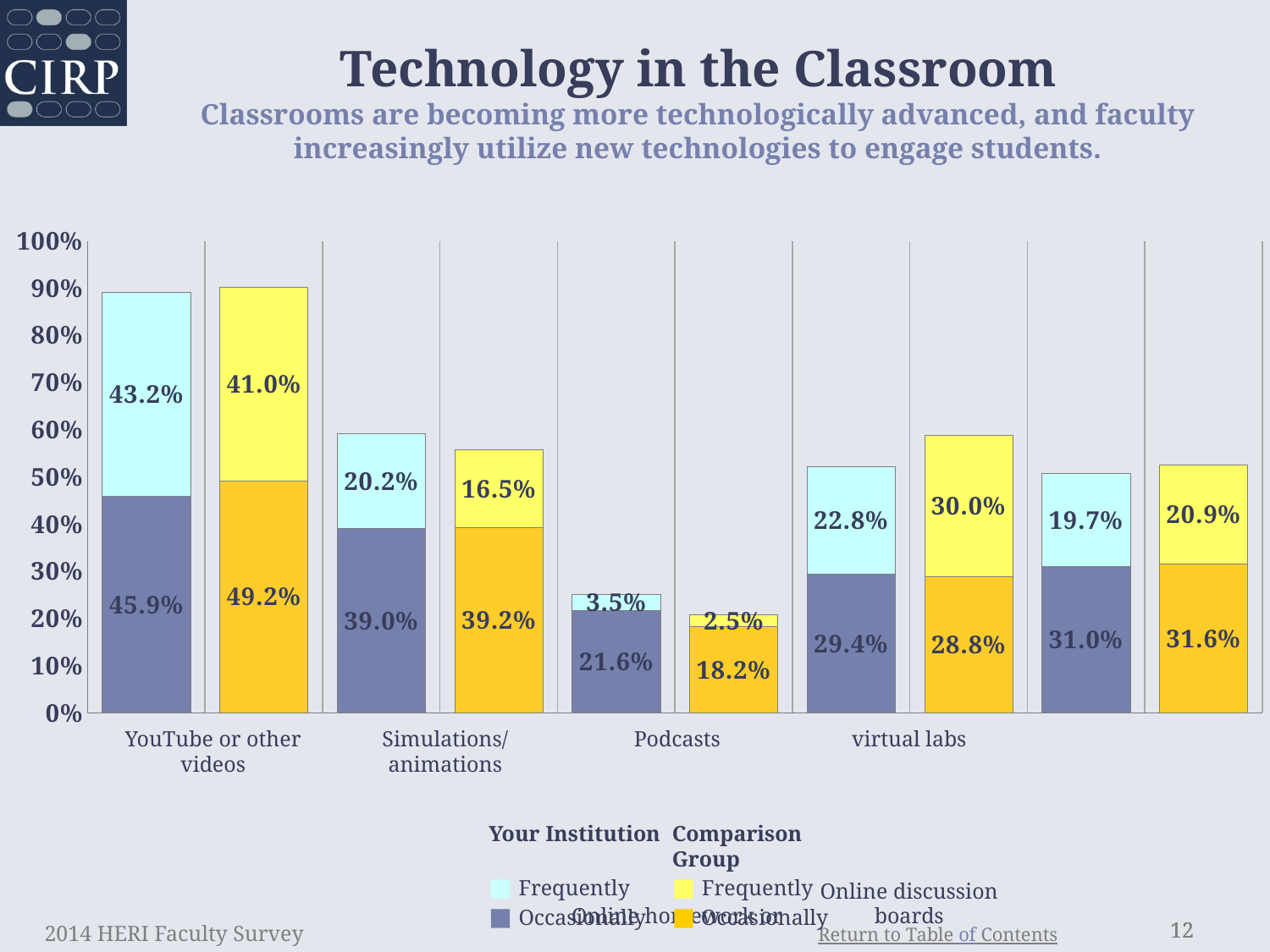
What is the 'Occasionally' value for Your Institution for Simulations/animations? 39.0% Which is larger for Simulations/animations: Your Institution's 'Frequently' value or the Comparison Group's 'Frequently' value? Your Institution (20.2%) Among the readable categories, which has the lowest 'Frequently' value for Your Institution? Podcasts What is the 'Frequently' value for the Comparison Group for virtual labs? 30.0% What is the total stacked value for the Comparison Group for Podcasts? 20.7% What percentage of faculty at Your Institution report using YouTube or other videos frequently? 43.2% What is the Comparison Group's 'Occasionally' value for Podcasts? 18.2% How many series does the legend list? 4 Is the total stacked bar for Your Institution for Podcasts greater or less than 30%? less What type of chart is shown on the slide? Stacked bar chart What is the total stacked value (Frequently plus Occasionally) for Your Institution for YouTube or other videos? 89.1% What is the difference between the Comparison Group's and Your Institution's 'Frequently' values for virtual labs? 7.2%